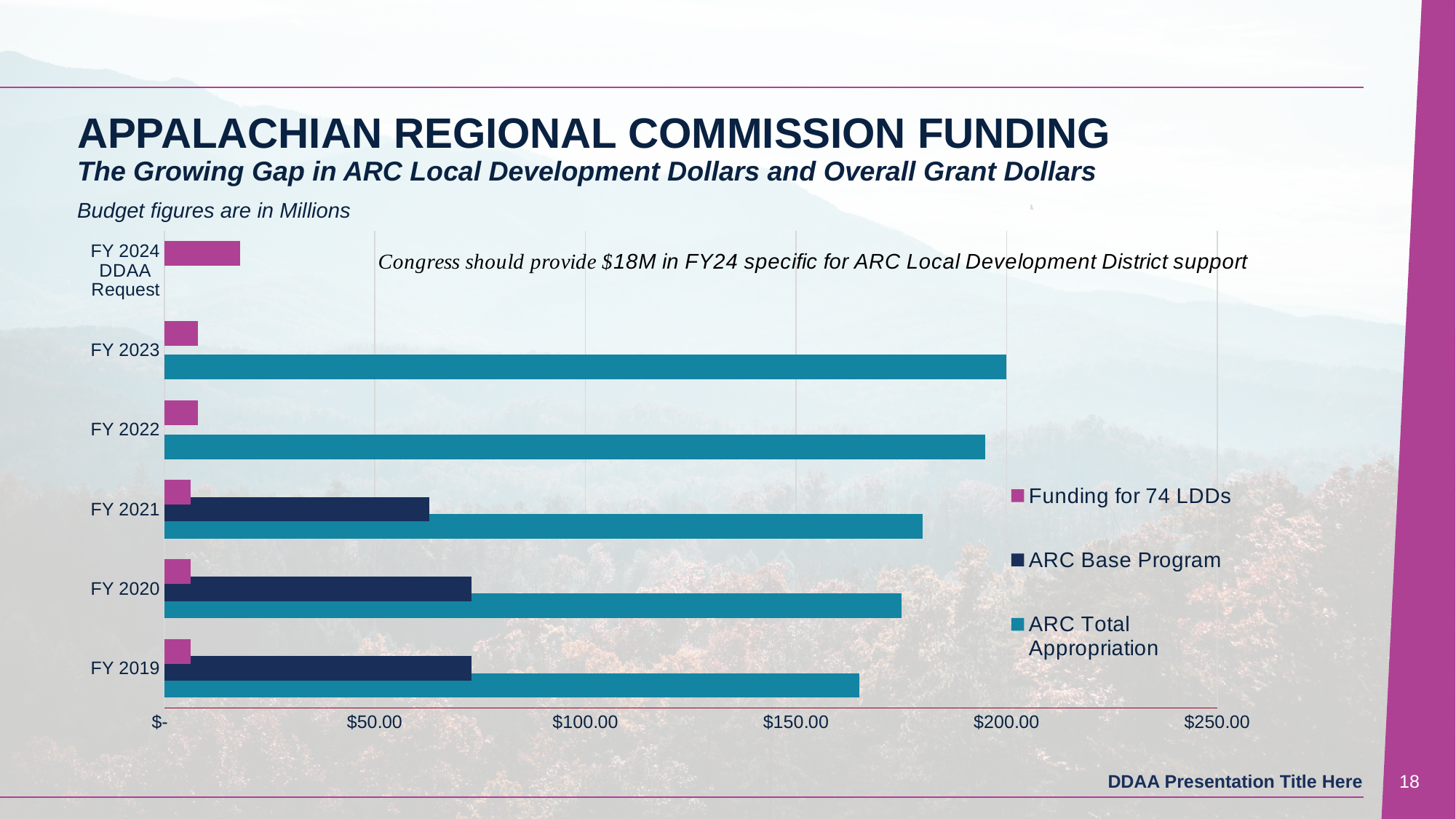
How many fiscal-year categories are shown on the chart's vertical axis? 6 Does the ARC Total Appropriation generally rise or fall from FY 2019 to FY 2023? rise Which fiscal year has the lowest ARC Total Appropriation? FY 2019 Is the ARC Total Appropriation value for FY 2019 greater or less than $150.00? greater Which series is shown in pink in the chart legend? Funding for 74 LDDs Is the ARC Base Program value for FY 2019 greater or less than $50.00? greater Is the ARC Total Appropriation value for FY 2021 greater or less than $200.00? less According to the annotation on the chart, how much should Congress provide in FY24 for ARC Local Development District support? $18M How many series does the chart legend list? 3 Which is larger, the ARC Base Program value for FY 2020 or for FY 2021? FY 2020 What kind of chart is shown on the slide? bar chart